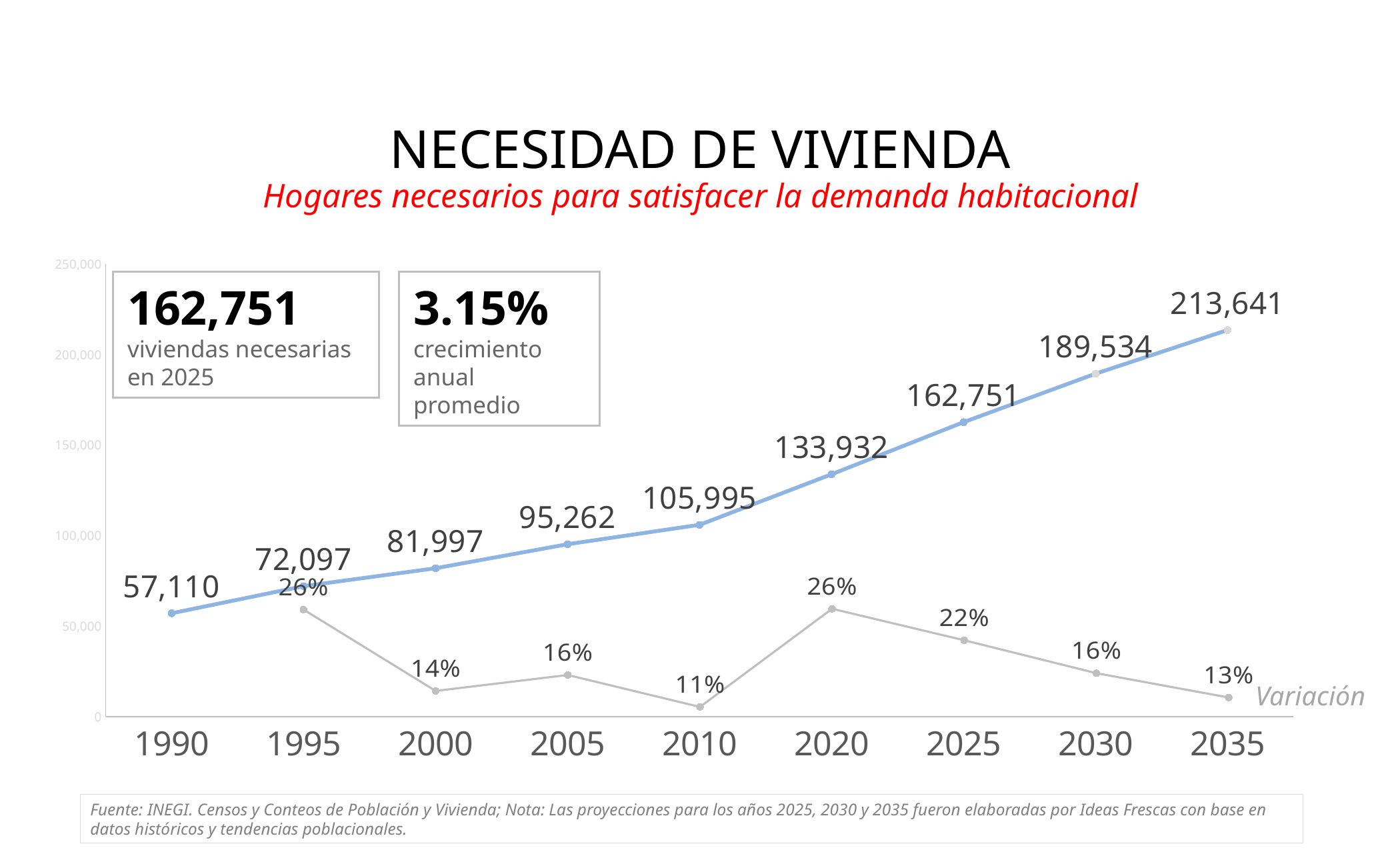
What is the number of homes needed in 2010? 105,995 What is the difference between the homes needed in 2030 and in 2025? 26,783 Does the number of homes needed rise or fall from 1990 to 2035? Rise How many years are shown on the x axis? 9 Which year has the highest number of homes needed? 2035 What kind of chart is shown on the slide? Line chart Which year has the lowest number of homes needed? 1990 What is the variation percentage shown for 2020? 26% Which year has the lowest variation percentage on the gray line? 2010 What is the difference between the homes needed in 1995 and in 1990? 14,987 Which is larger, the variation percentage for 2025 or for 2030? 2025 What is the number of homes needed in 2035? 213,641